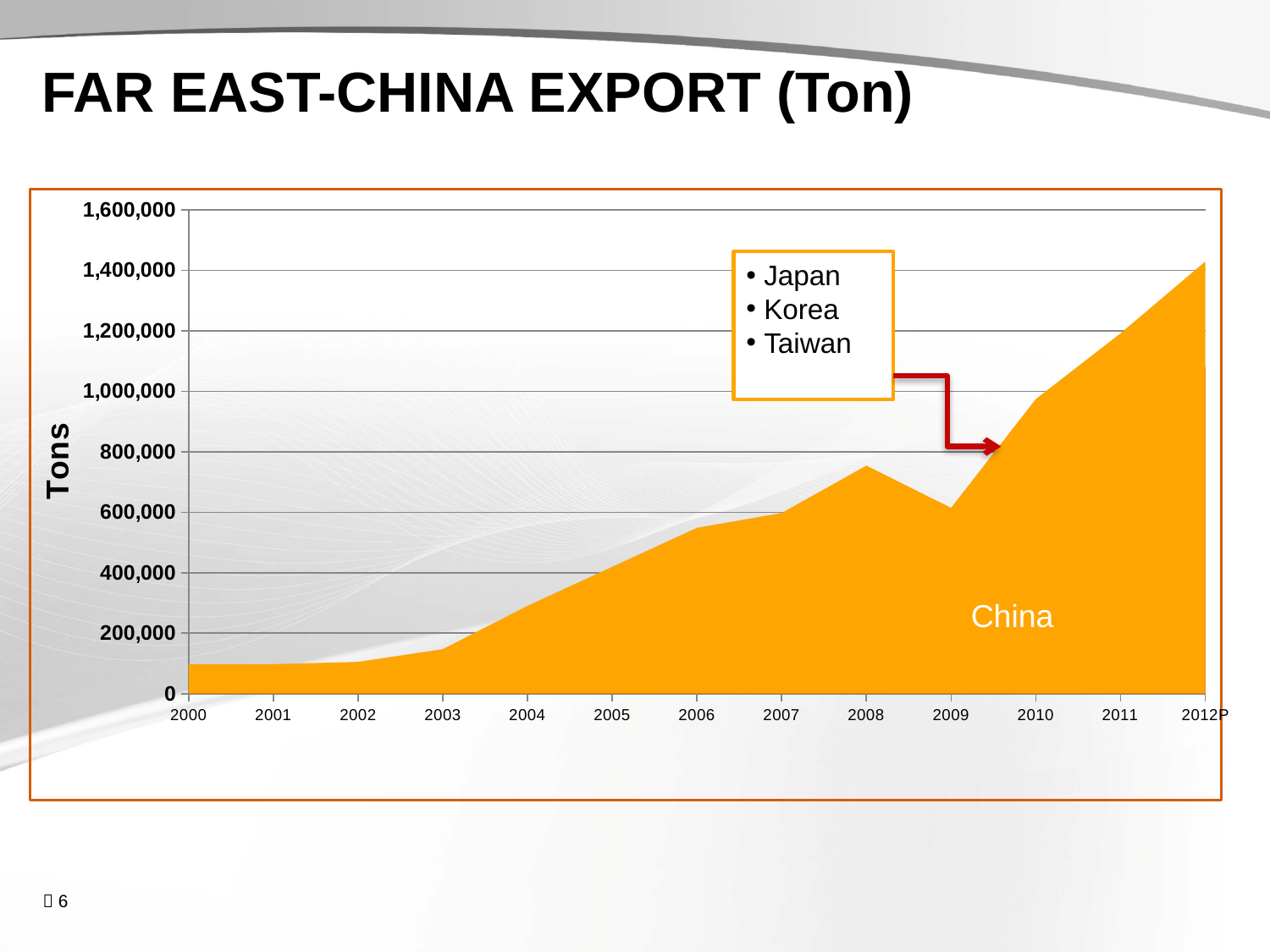
Is the value for 2012P greater or less than 1,400,000? greater What is the title of the chart on the slide? FAR EAST-CHINA EXPORT (Ton) Is the value for 2011 greater or less than 1,000,000? greater Is the value for 2003 greater or less than 200,000? less Which year has the highest export value in the chart? 2012P Which year has the larger export value, 2008 or 2009? 2008 What kind of chart is shown on the slide? area chart Do the export values generally rise or fall from 2000 to 2012P? rise What label is shown on the vertical axis of the chart? Tons How many years are shown along the x axis of the chart? 13